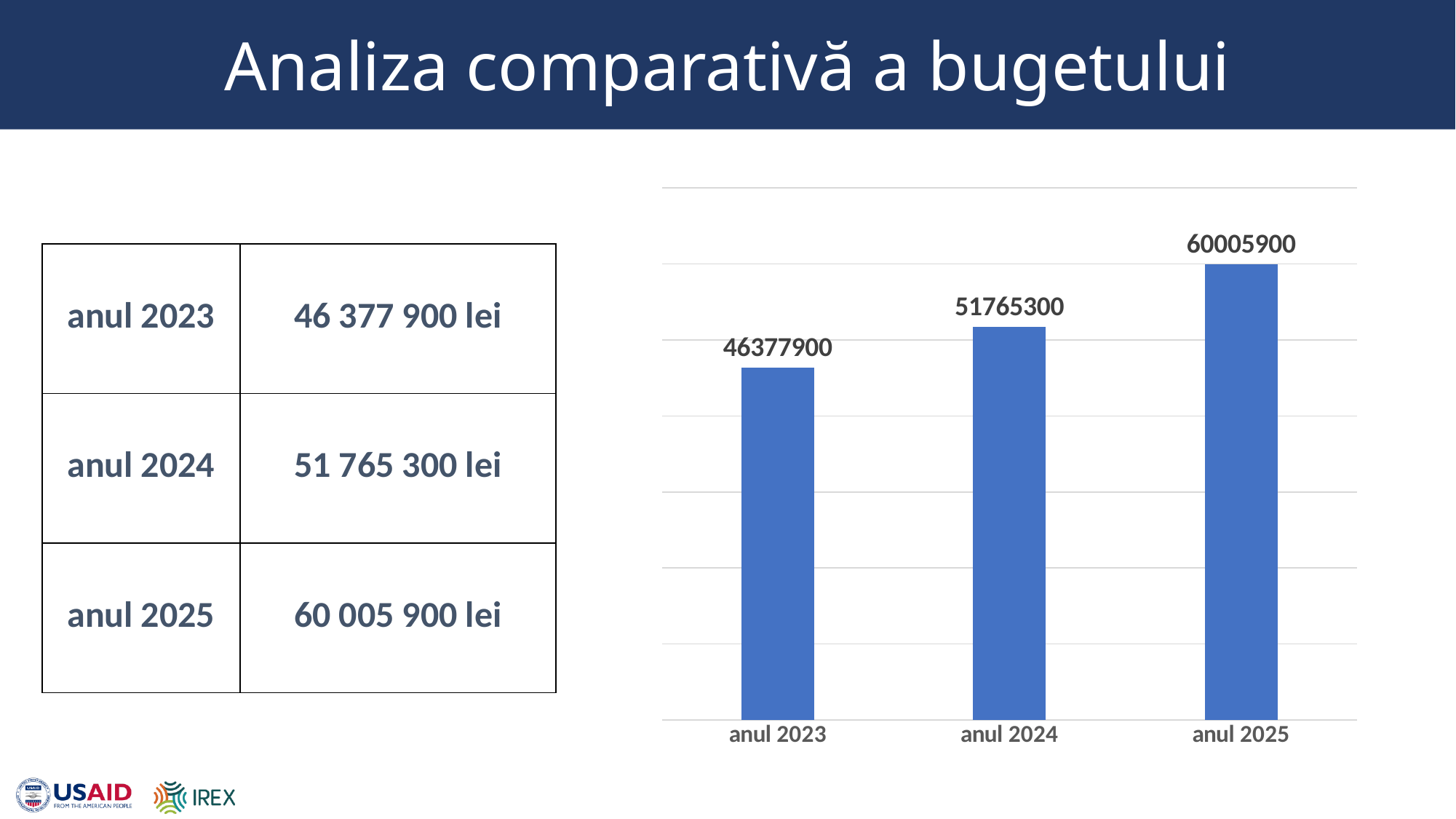
What is the difference between the values for anul 2025 and anul 2023 in the bar chart? 13628000 Which year has the lowest value in the bar chart? anul 2023 What is the difference between the values for anul 2024 and anul 2023 in the bar chart? 5387400 What is the value shown for anul 2025 in the bar chart? 60005900 How many bars are shown in the chart? 3 What is the difference between the values for anul 2025 and anul 2024 in the bar chart? 8240600 Which is larger in the bar chart, the value for anul 2024 or the value for anul 2025? anul 2025 What is the value shown for anul 2023 in the bar chart? 46377900 What is the value shown for anul 2024 in the bar chart? 51765300 What kind of chart is shown on the slide? bar chart Which year has the highest value in the bar chart? anul 2025 Do the values in the bar chart rise or fall from anul 2023 to anul 2025? rise